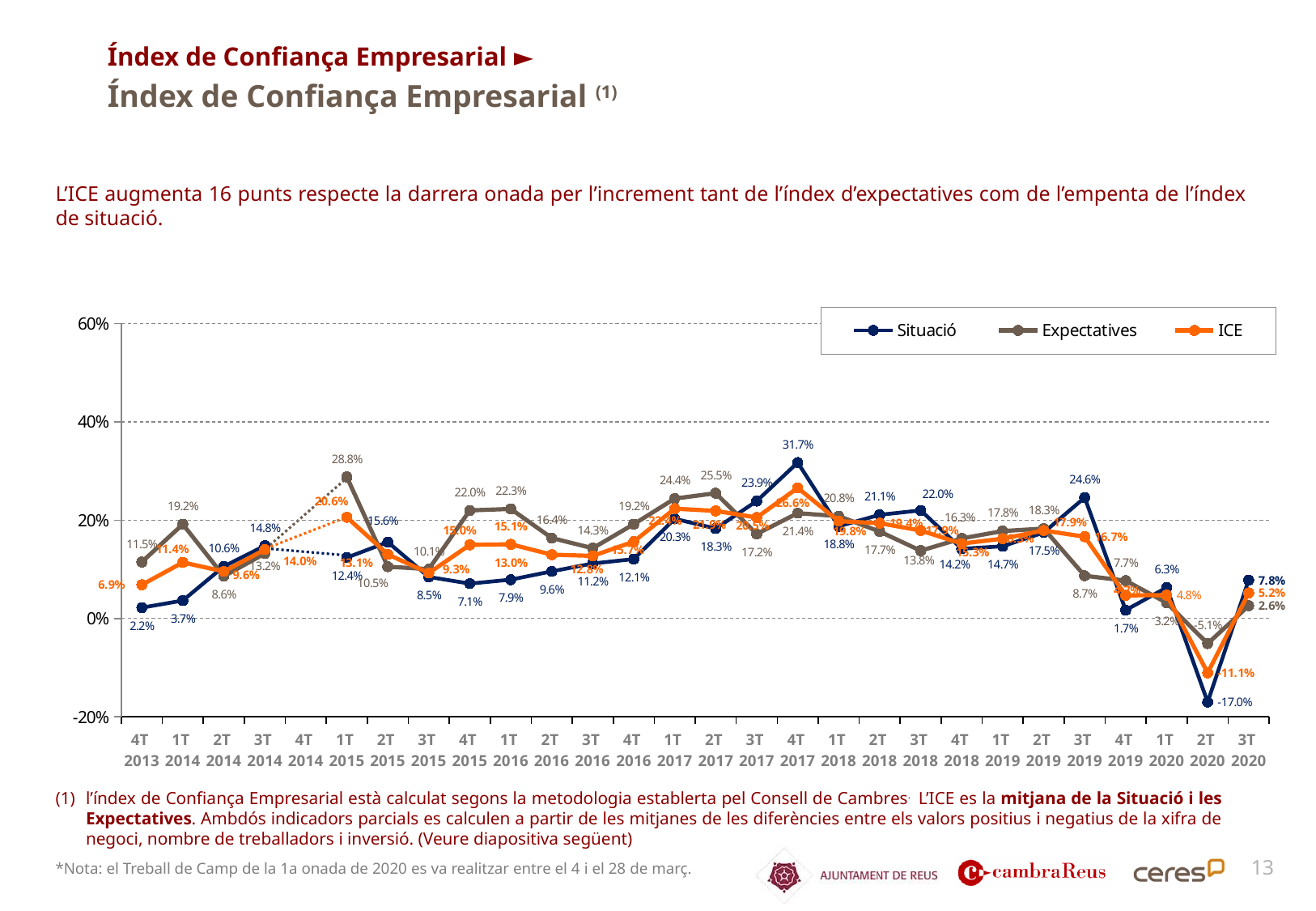
How many quarters are shown on the x axis? 28 How many series does the legend list? 3 Is the value of Expectatives in 2T 2020 greater or less than 0%? less In 4T 2017, which is larger: Situació or Expectatives? Situació What is the value of Expectatives in 1T 2015? 28.8% What is the value of Situació in 4T 2013? 2.2% In which quarter does Situació reach its lowest value? 2T 2020 By how many percentage points did ICE change from 2T 2020 to 3T 2020? 16.3 percentage points What is the value of ICE in 2T 2020? -11.1% In which quarter does Expectatives reach its highest value? 1T 2015 What kind of chart is shown on the slide? line chart What is the value of Situació in 4T 2017? 31.7%